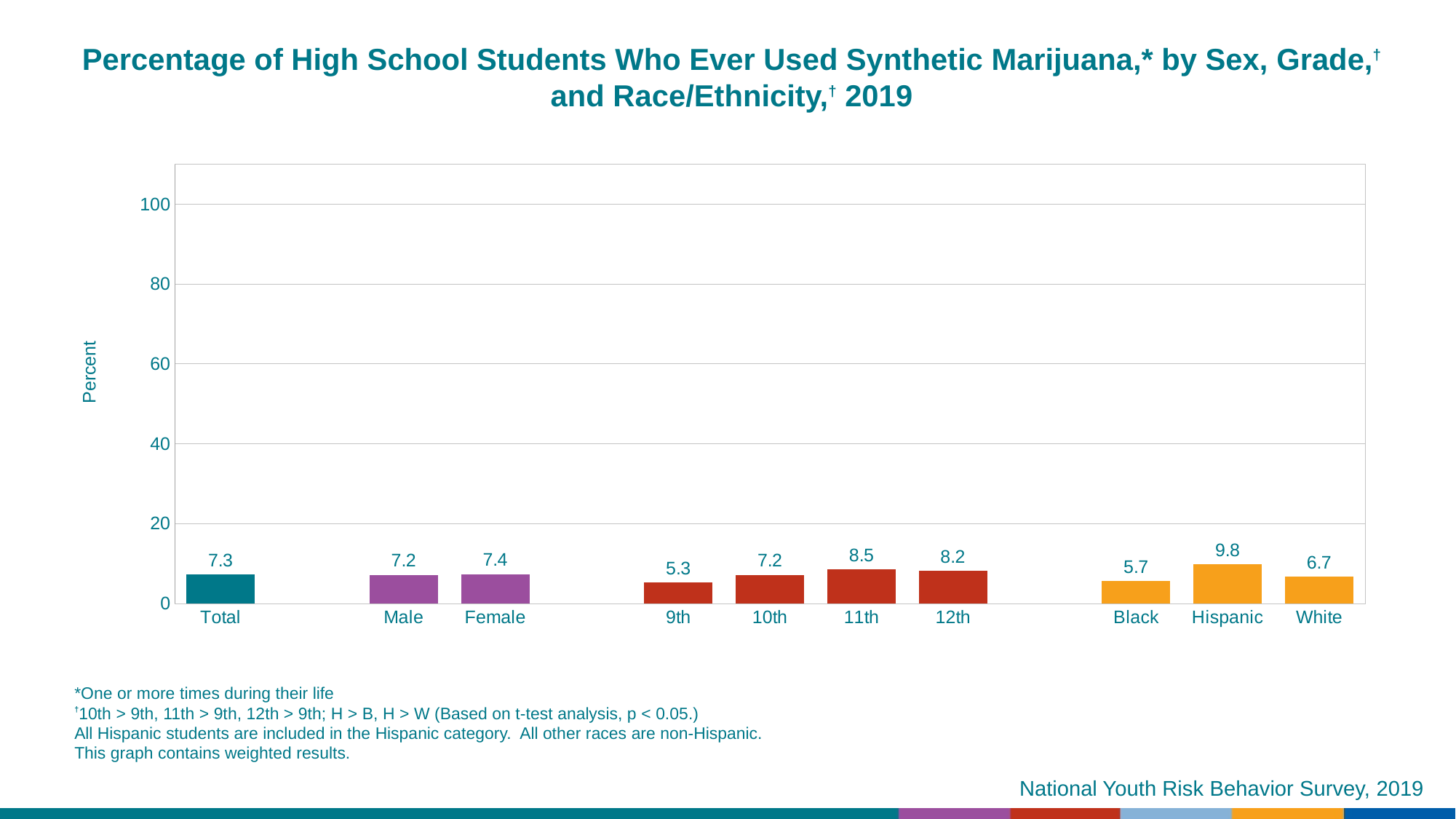
Which category has the lowest value? 9th Which is larger, the value for Male or the value for Female? Female What is the value for Total? 7.3 What is the difference between the values for 11th grade and 9th grade? 3.2 Which category has the highest value? Hispanic What kind of chart is this? bar chart What is the value for Hispanic students? 9.8 What is the value for 9th grade students? 5.3 What is the label on the y axis? Percent Do the values rise or fall from 9th grade to 11th grade? rise How many categories are shown on the x axis? 10 Is the value for White greater or less than 20? less